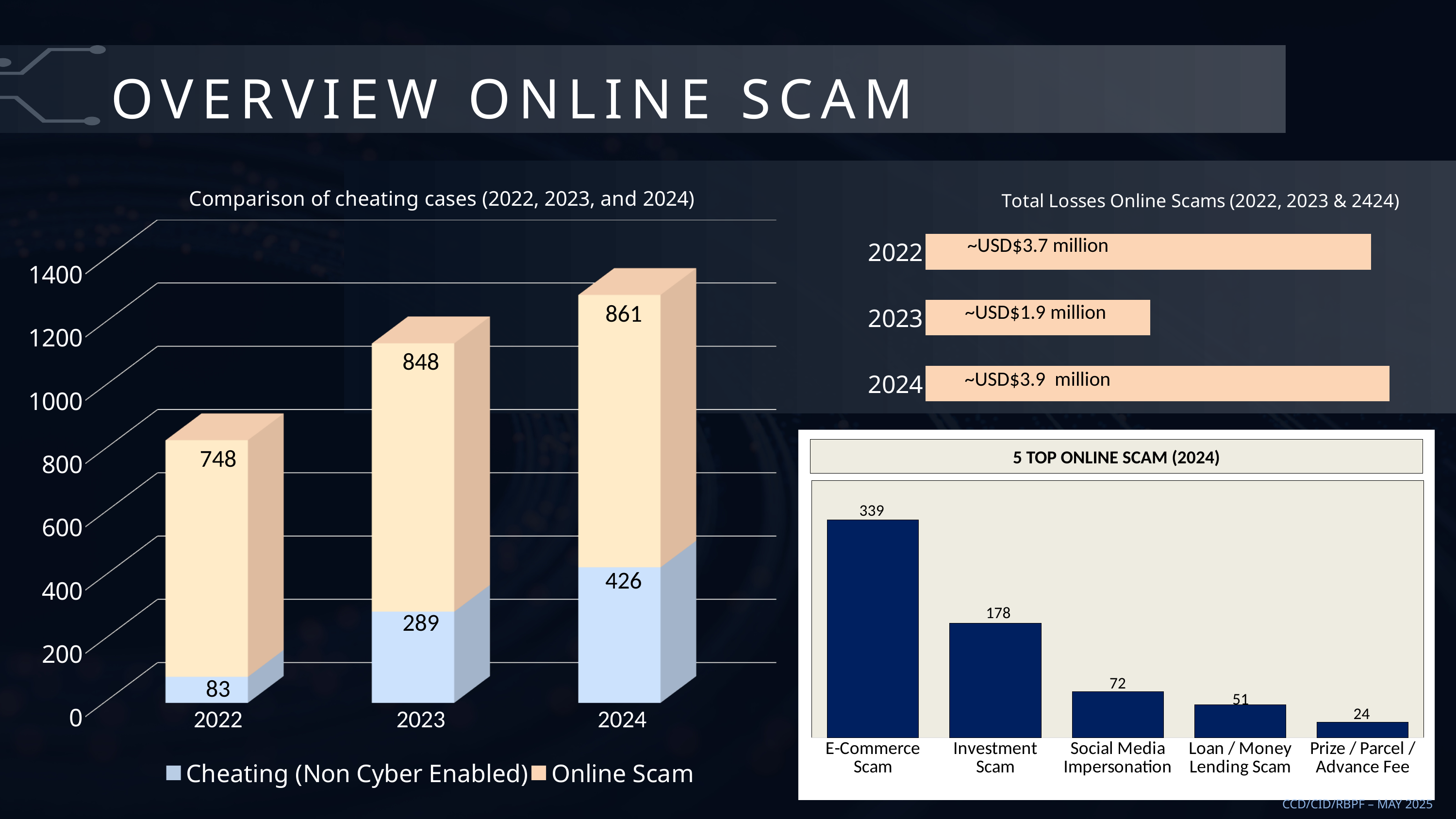
In the '5 TOP ONLINE SCAM (2024)' chart, which category has the lowest value? Prize / Parcel / Advance Fee In the '5 TOP ONLINE SCAM (2024)' chart, what is the value for Investment Scam? 178 In the 'Total Losses Online Scams' chart, what is the value for 2023? ~USD$1.9 million In the 'Total Losses Online Scams' chart, which year has the highest total losses? 2024 In the '5 TOP ONLINE SCAM (2024)' chart, what is the difference between E-Commerce Scam and Social Media Impersonation? 267 In the 'Comparison of cheating cases' chart, what is the Cheating (Non Cyber Enabled) value for 2022? 83 In the 'Comparison of cheating cases' chart, what is the difference between the Online Scam values for 2024 and 2022? 113 In the 'Comparison of cheating cases' chart, do the Cheating (Non Cyber Enabled) values rise or fall from 2022 to 2024? rise In the 'Comparison of cheating cases' chart, what is the Online Scam value for 2023? 848 In the 'Comparison of cheating cases' chart, what is the total of the stacked bar for 2024? 1287 In the 'Comparison of cheating cases' chart, how many series does the legend list? 2 What kind of chart is the '5 TOP ONLINE SCAM (2024)' chart? bar chart